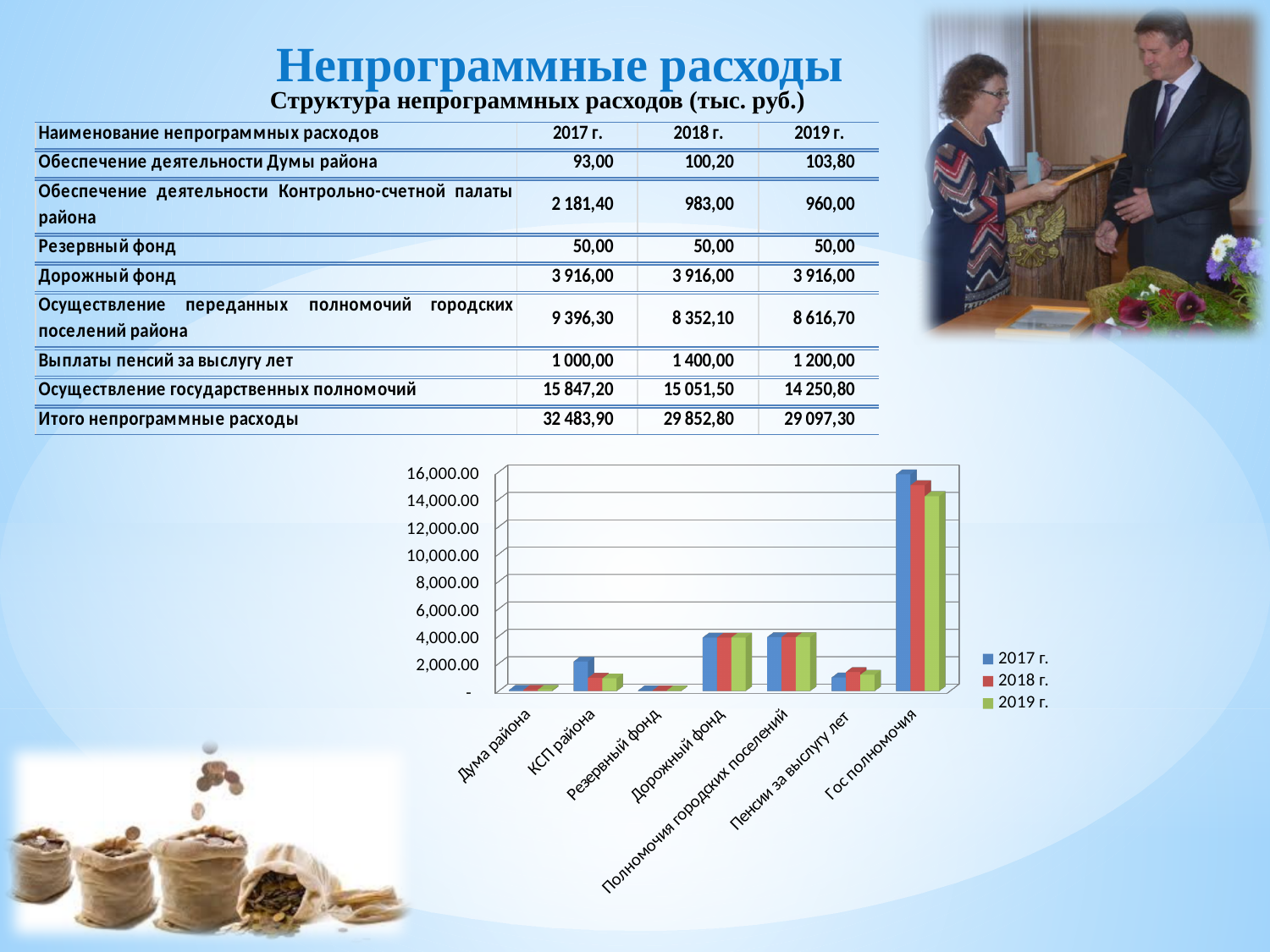
What kind of chart is shown on the slide? bar chart According to the table, what is the value of Дорожный фонд in 2019 г.? 3 916,00 In the chart, is the 2018 г. value for Пенсии за выслугу лет greater or less than 2,000.00? less In the chart, is the 2017 г. value for Дорожный фонд greater or less than 6,000.00? less How many categories are shown along the x axis of the chart? 7 In the chart, which is larger for Пенсии за выслугу лет: the 2017 г. bar or the 2018 г. bar? 2018 г. In the chart, is the 2017 г. value for Гос полномочия greater or less than 14,000.00? greater In the chart, which is larger for КСП района: the 2017 г. bar or the 2018 г. bar? 2017 г. How many series does the chart legend list? 3 In the chart, do the bars for Гос полномочия rise or fall from 2017 г. to 2019 г.? fall According to the table, what is the difference between Итого непрограммные расходы in 2017 г. and 2018 г.? 2 631,10 Which category has the highest bars in the chart? Гос полномочия